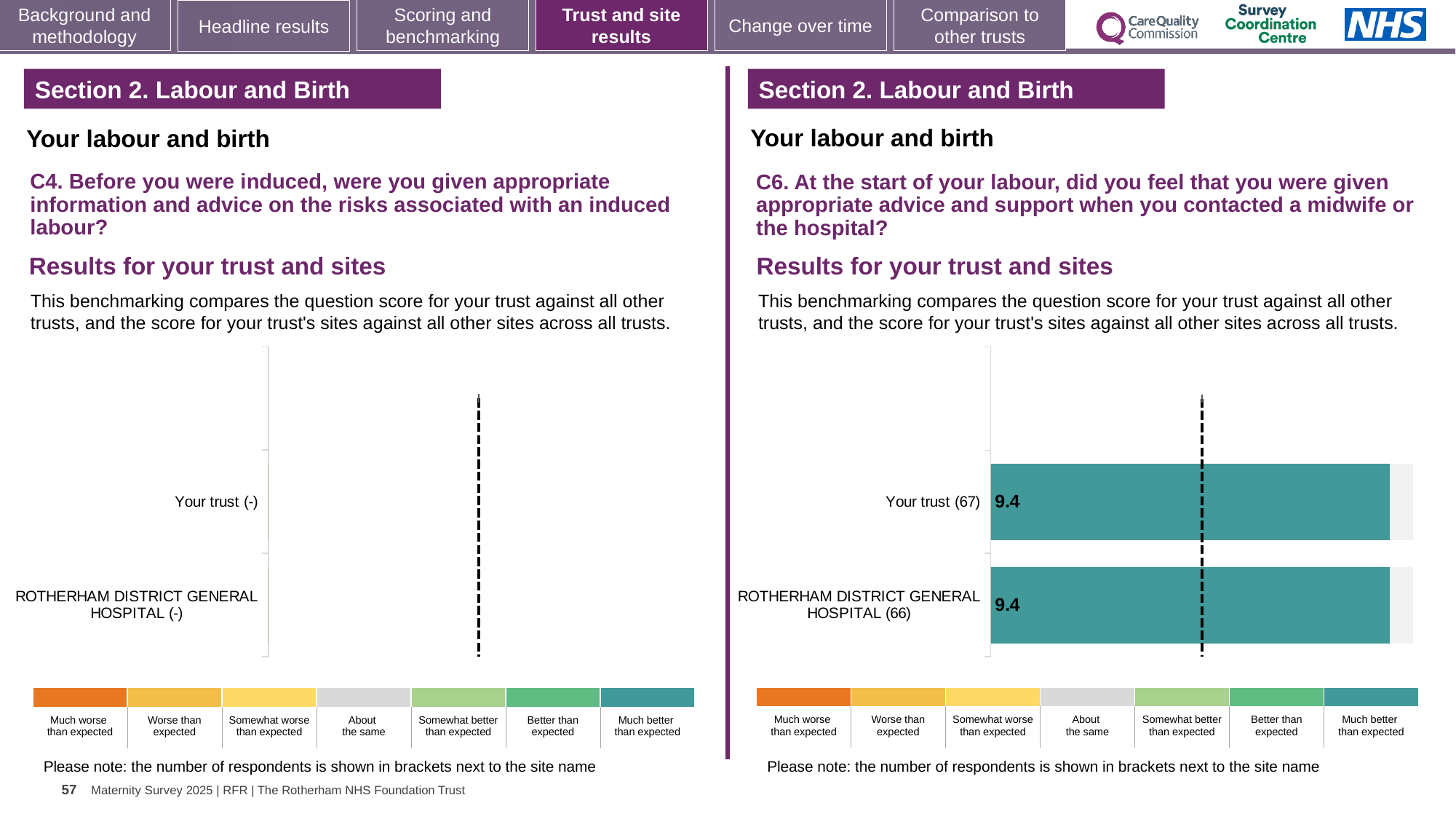
What kind of chart is the right-hand chart (C6)? bar chart On the right-hand chart (C6), which benchmark category in the colour key matches the colour of the plotted bars? Much better than expected On the right-hand chart (C6), what is the difference between the score for Your trust and the score for ROTHERHAM DISTRICT GENERAL HOSPITAL? 0.0 On the right-hand chart (C6), how many respondents are shown in brackets for ROTHERHAM DISTRICT GENERAL HOSPITAL? 66 On the right-hand chart (C6), how many respondents are shown in brackets for Your trust? 67 On the left-hand chart (C4), what is shown in brackets next to Your trust? - On the right-hand chart (C6), what is the score for ROTHERHAM DISTRICT GENERAL HOSPITAL? 9.4 How many benchmark categories are shown in the colour key below the right-hand chart (C6)? 7 On the right-hand chart (C6), is the score for Your trust higher than, lower than, or equal to the score for ROTHERHAM DISTRICT GENERAL HOSPITAL? equal On the left-hand chart (C4), how many categories are listed on the axis? 2 On the right-hand chart (C6), what is the score for Your trust? 9.4 On the right-hand chart (C6), how many bars are plotted? 2